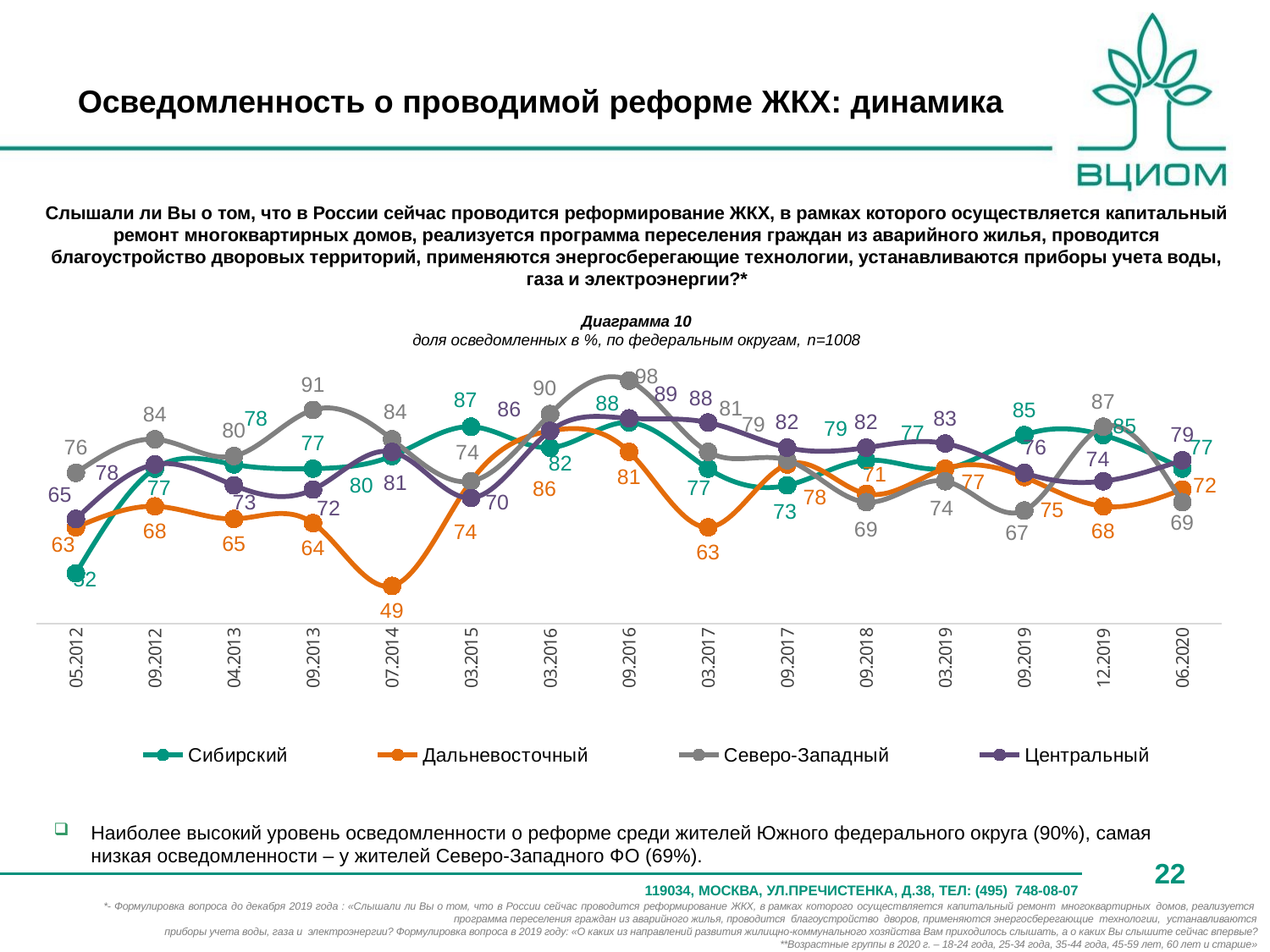
How many series does the legend list? 4 What kind of chart is shown on the slide? line chart At which time point does Северо-Западный reach its highest value? 09.2016 What is the value for Северо-Западный at 06.2020? 69 What is the number of the diagram given in the chart title? Диаграмма 10 What is the difference between the Дальневосточный values at 03.2015 (74) and 07.2014 (49)? 25 What is the value for Дальневосточный at 07.2014? 49 At 07.2014, which is larger: Северо-Западный or Дальневосточный? Северо-Западный What is the value for Сибирский at 05.2012? 52 How many time points are shown on the x axis? 15 What is the value for Северо-Западный at 09.2013? 91 At which time point does Дальневосточный have its lowest value? 07.2014